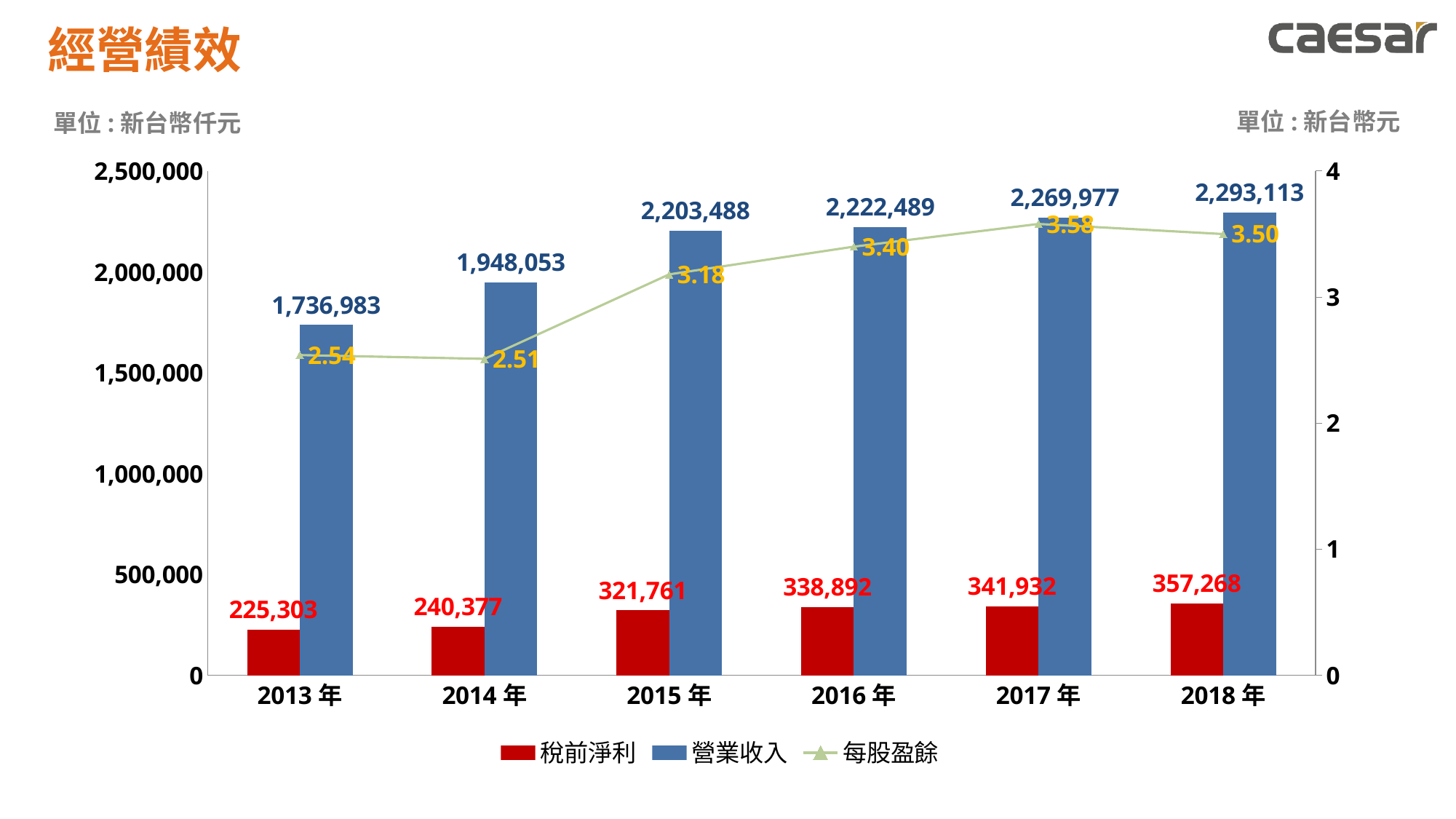
Which is larger, the 每股盈餘 for 2017 年 or for 2018 年? 2017 年 What is the difference in 稅前淨利 between 2018 年 and 2017 年? 15,336 What is the 稅前淨利 value for 2013 年? 225,303 Which year has the lowest 每股盈餘? 2014 年 What is the 營業收入 value for 2015 年? 2,203,488 What colour are the 營業收入 bars? blue How many years are shown on the x axis? 6 Which year has the highest 營業收入? 2018 年 Does the 稅前淨利 rise or fall from 2013 年 to 2018 年? rise Is the 營業收入 value for 2014 年 greater or less than 2,000,000? less How many series does the legend list? 3 What is the 每股盈餘 value for 2017 年? 3.58